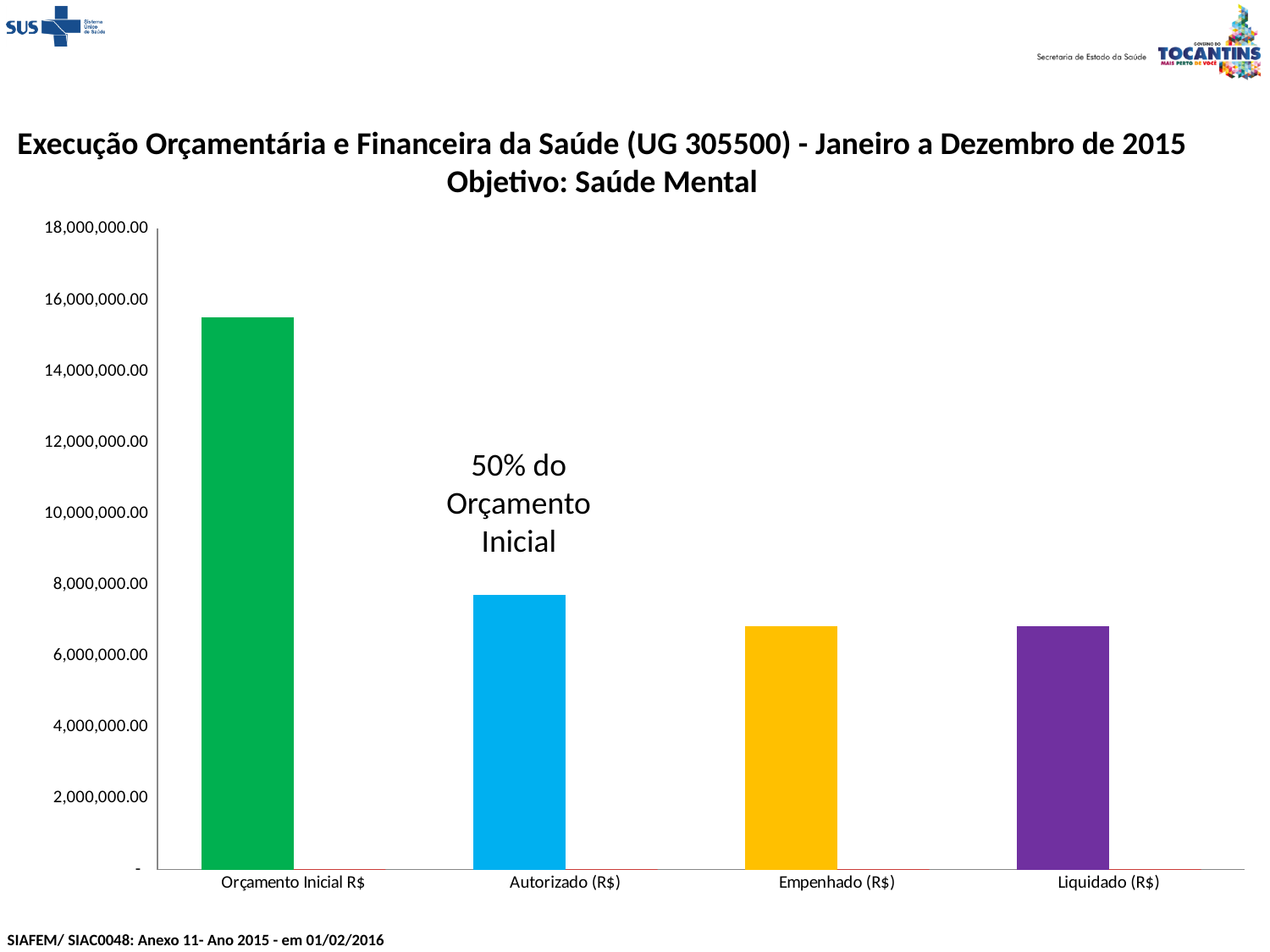
What kind of chart is shown on the slide? bar chart Is the value for Empenhado (R$) greater or less than 8,000,000.00? less Is the value for Orçamento Inicial R$ greater or less than 16,000,000.00? less How many categories are plotted on the x axis? 4 Which is larger, the value for Orçamento Inicial R$ or the value for Autorizado (R$)? Orçamento Inicial R$ Is the value for Autorizado (R$) greater or less than 8,000,000.00? less What text annotation is placed above the Autorizado (R$) bar? 50% do Orçamento Inicial Which category has the highest value? Orçamento Inicial R$ What objective (Objetivo) is named in the chart title? Saúde Mental